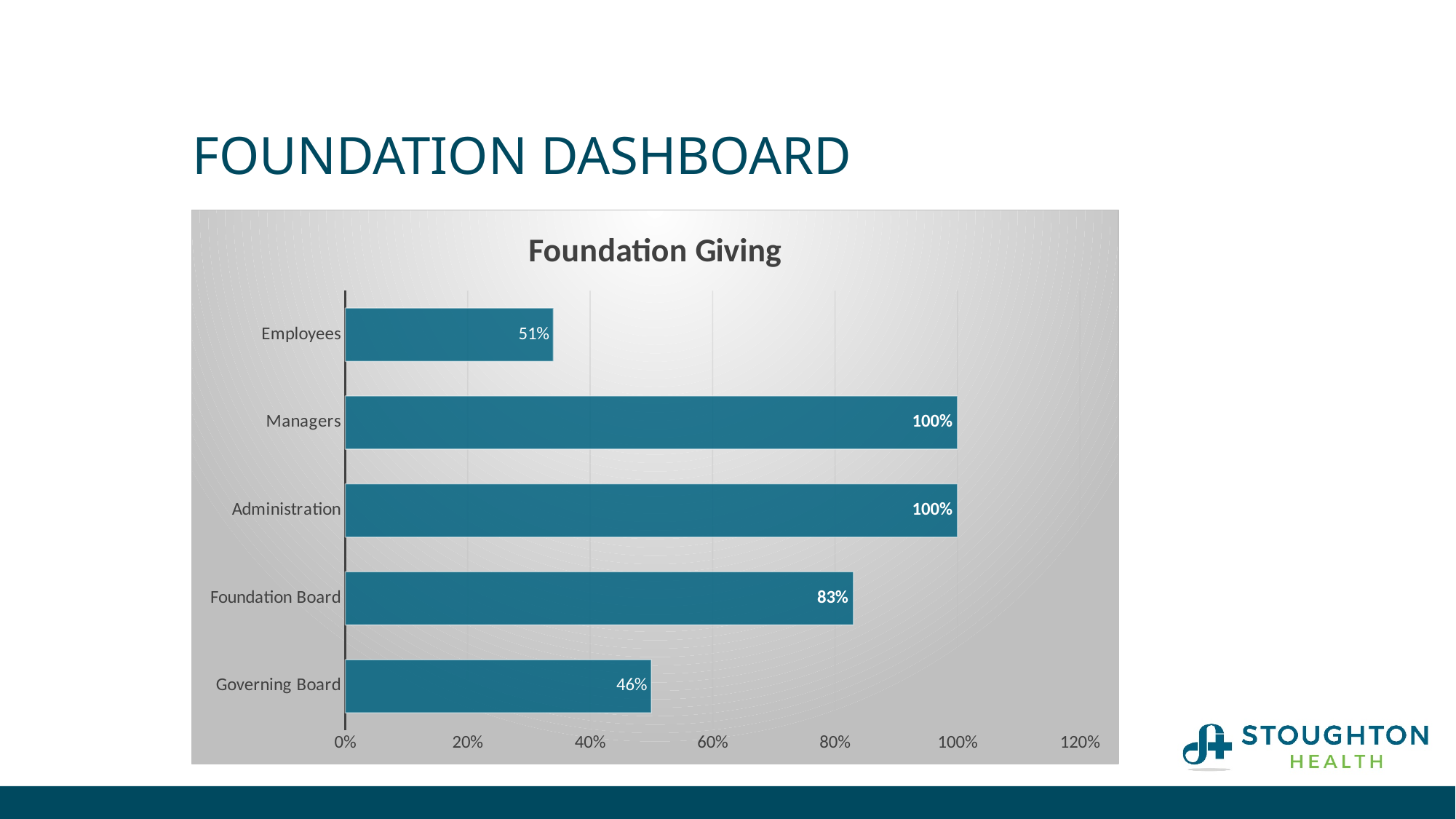
What is the value for Foundation Board? 83% What type of chart is shown on the slide? Bar chart What is the title of the chart? Foundation Giving What is the value for Governing Board? 46% How many categories are shown in the chart? 5 What is the value for Employees? 51% What is the difference between the values for Administration and Employees? 49% Which two categories share the highest value of 100%? Managers and Administration Which is larger, the value for Employees or the value for Foundation Board? Foundation Board What is the difference between the values for Foundation Board and Governing Board? 37% What is the value for Managers? 100%